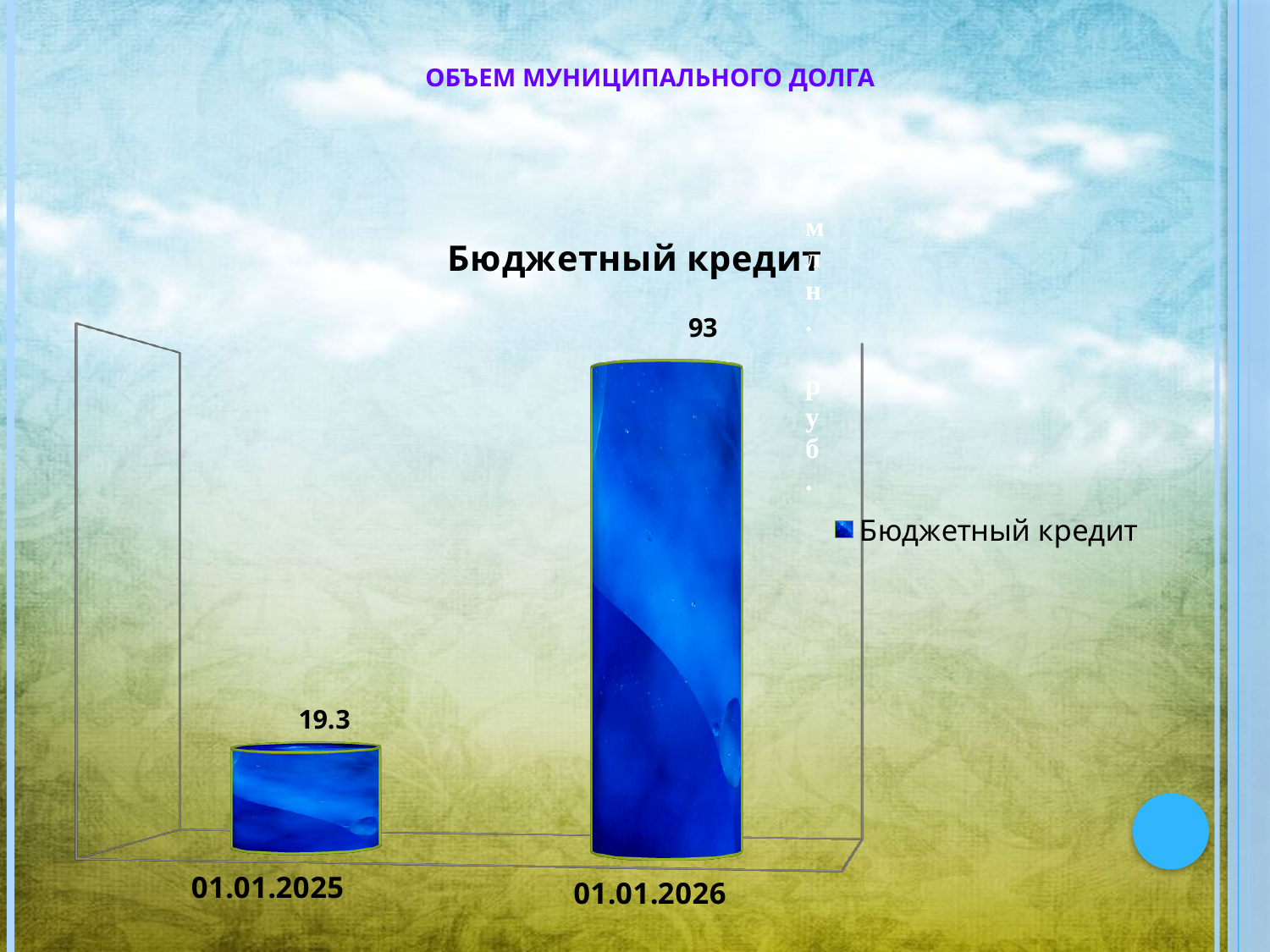
What is the title of the chart? Бюджетный кредит What is the value for 01.01.2025? 19.3 What is the difference between the values for 01.01.2026 and 01.01.2025? 73.7 Do the values rise or fall from 01.01.2025 to 01.01.2026? rise What series name is listed in the legend? Бюджетный кредит Which is larger, the value for 01.01.2025 or for 01.01.2026? 01.01.2026 What kind of chart is shown? bar chart What is the value for 01.01.2026? 93 How many categories are shown on the x axis? 2 How many series does the legend list? 1 Which category has the highest value? 01.01.2026 Which category has the lowest value? 01.01.2025